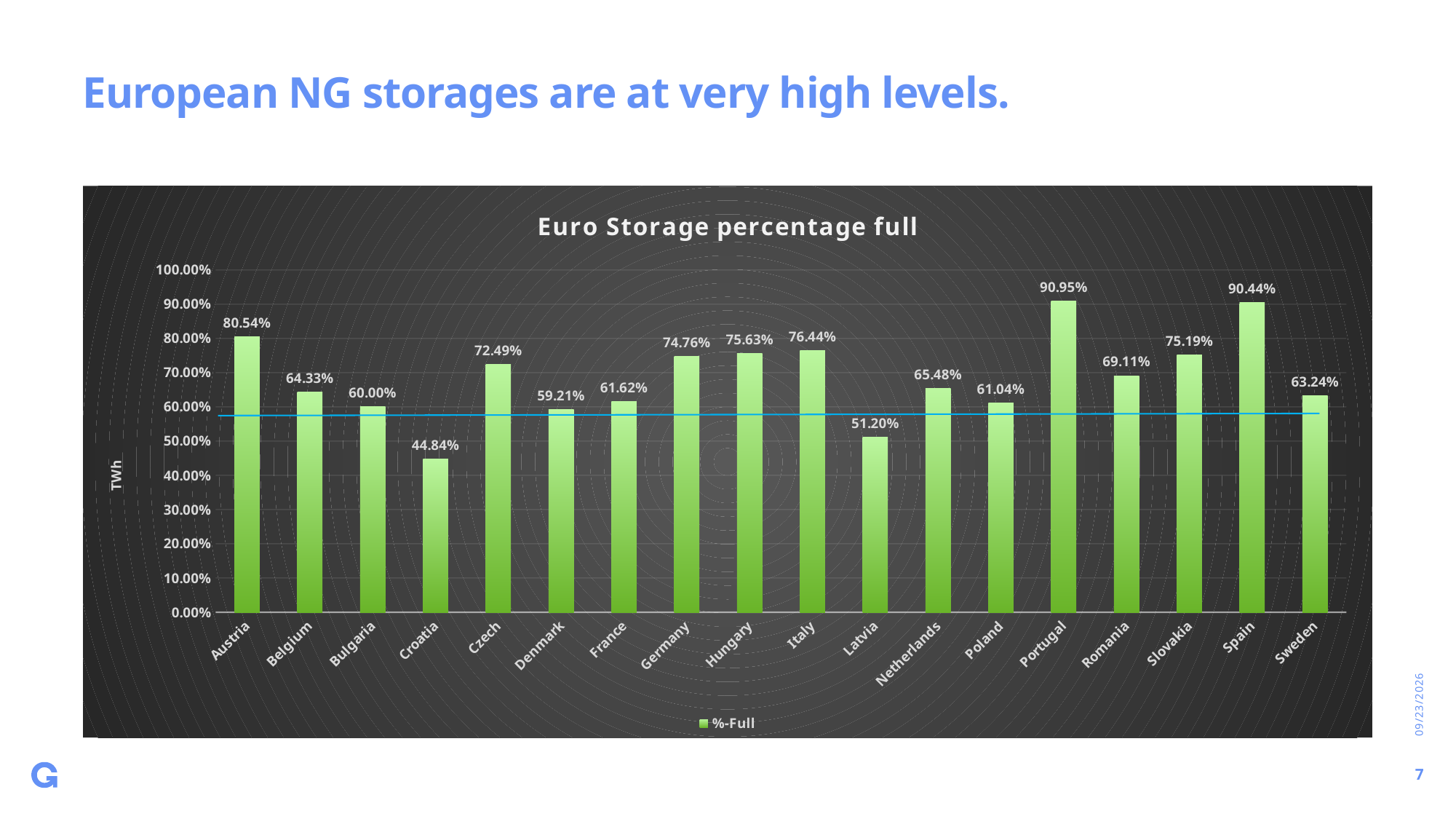
What is the title of the chart? Euro Storage percentage full Is the value for Netherlands greater or less than 60.00%? greater How many countries are shown on the x axis? 18 Which country has the highest storage percentage full? Portugal Which country has the lowest storage percentage full? Croatia Which has a higher storage percentage full, Italy or Hungary? Italy What kind of chart is shown on the slide? Bar chart What is the storage percentage full for Latvia? 51.20% What is the difference between the storage percentage full for Portugal and Spain? 0.51% What is the storage percentage full for Germany? 74.76% How many series does the legend list? 1 What is the storage percentage full for Austria? 80.54%